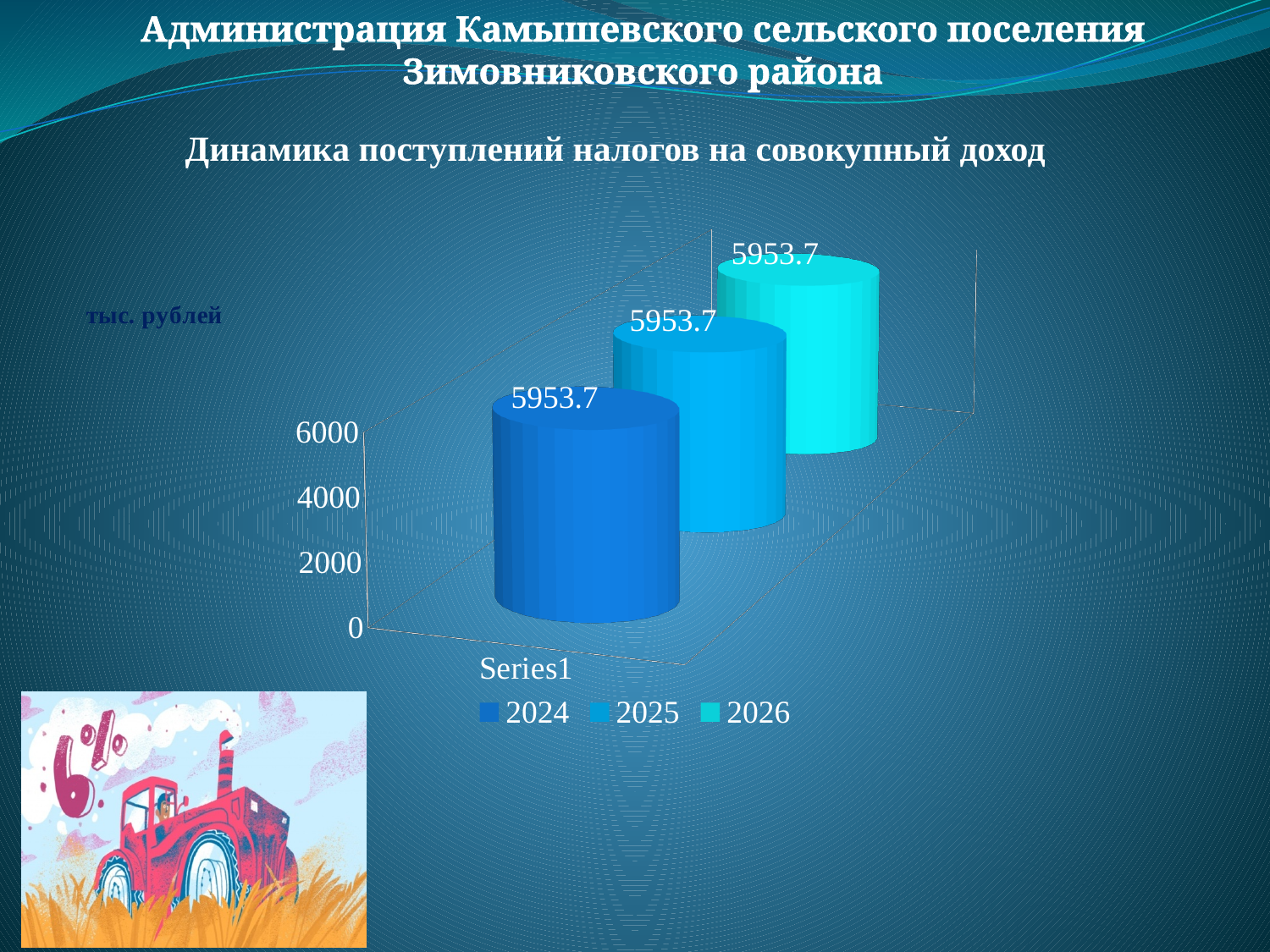
What is the value for 2024 in the chart? 5953.7 What is the value for 2026 in the chart? 5953.7 What is the category label shown on the horizontal axis? Series1 What kind of chart is shown on the slide? bar chart How many series does the legend list? 3 Is the value for 2025 greater or less than 4000? greater What is the highest value shown on the vertical axis? 6000 In what units are the chart values given, according to the label on the slide? тыс. рублей Do the values rise, fall, or stay the same from 2024 to 2026? stay the same What is the value for 2025 in the chart? 5953.7 What is the title of the chart? Динамика поступлений налогов на совокупный доход What is the difference between the values for 2026 and 2024? 0